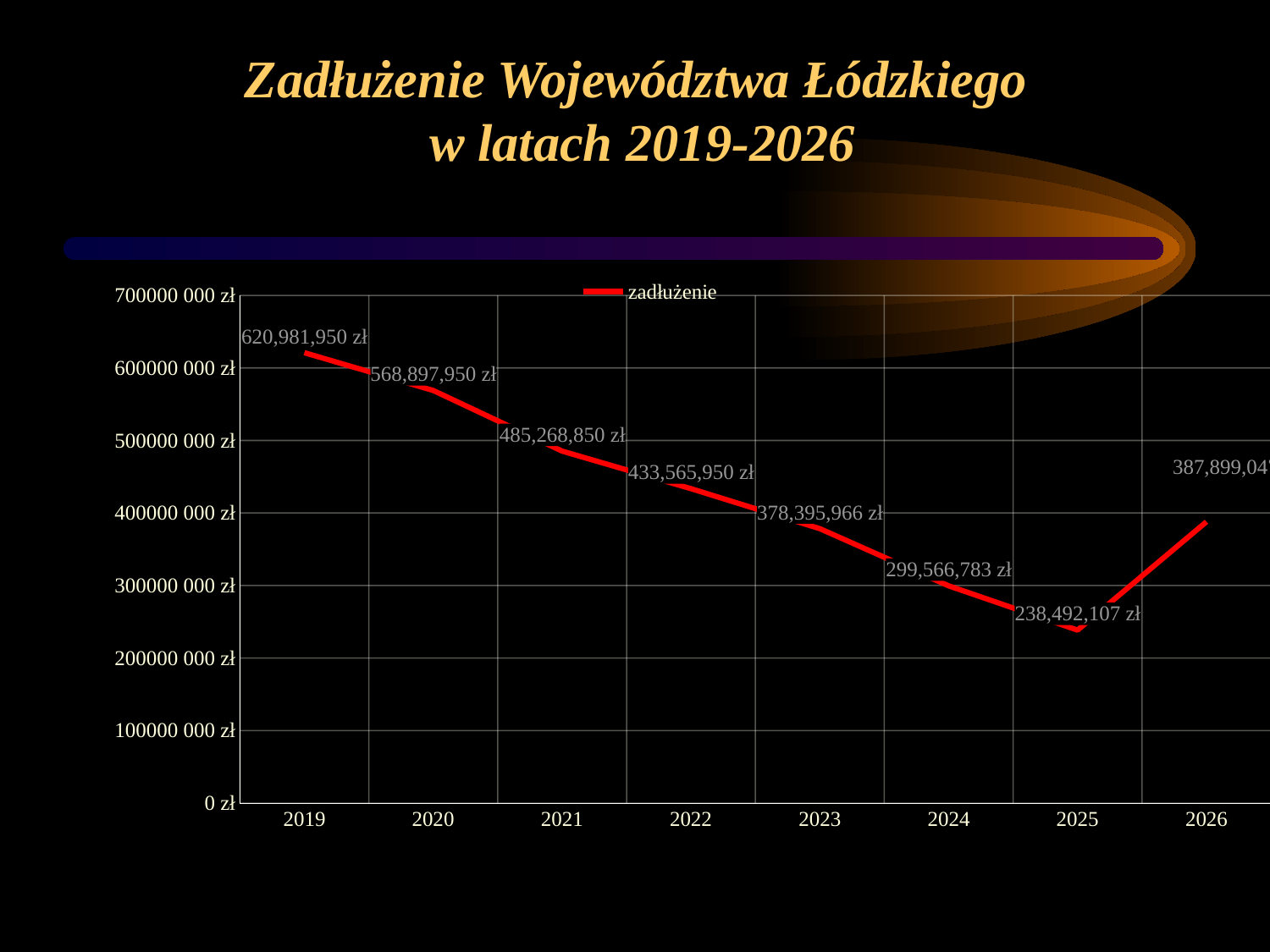
Is the value for 2026 greater or less than 300000 000 zł? greater Which year has the lowest debt value? 2025 How many years are plotted on the x axis? 8 Does the debt value rise or fall from 2019 to 2025? fall What kind of chart is shown on the slide? line chart What is the debt value shown for 2023? 378,395,966 zł What is the difference between the debt values for 2019 and 2020? 52,084,000 zł What is the debt value shown for 2025? 238,492,107 zł What is the debt value shown for 2019? 620,981,950 zł Which year has the highest debt value? 2019 How many series does the legend list? 1 Which year has the larger debt value, 2021 or 2022? 2021